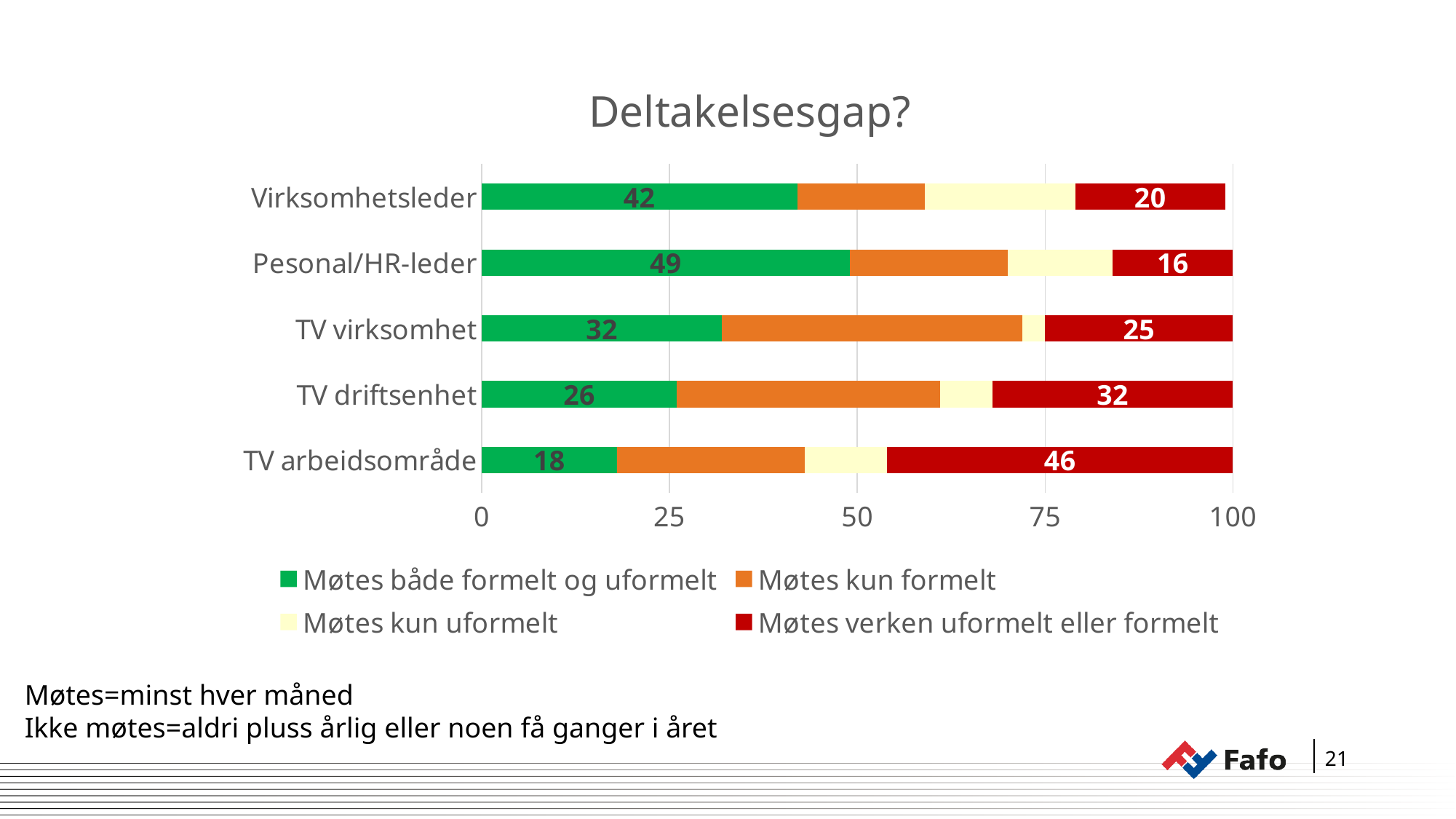
Which category has the lowest value for "Møtes verken uformelt eller formelt"? Pesonal/HR-leder What is the value of "Møtes både formelt og uformelt" for Virksomhetsleder? 42 What is the value of "Møtes verken uformelt eller formelt" for TV arbeidsområde? 46 What is the value of "Møtes både formelt og uformelt" for TV driftsenhet? 26 What kind of chart is shown on the slide? Stacked bar chart How many series does the legend list? 4 Is the "Møtes kun formelt" segment for TV driftsenhet greater or less than 25? greater Which is larger: the "Møtes både formelt og uformelt" value for TV virksomhet or for TV driftsenhet? TV virksomhet How many categories are shown on the y axis? 5 What is the value of "Møtes verken uformelt eller formelt" for Pesonal/HR-leder? 16 What is the difference between the "Møtes verken uformelt eller formelt" values for TV arbeidsområde and Virksomhetsleder? 26 Which category has the highest value for "Møtes både formelt og uformelt"? Pesonal/HR-leder